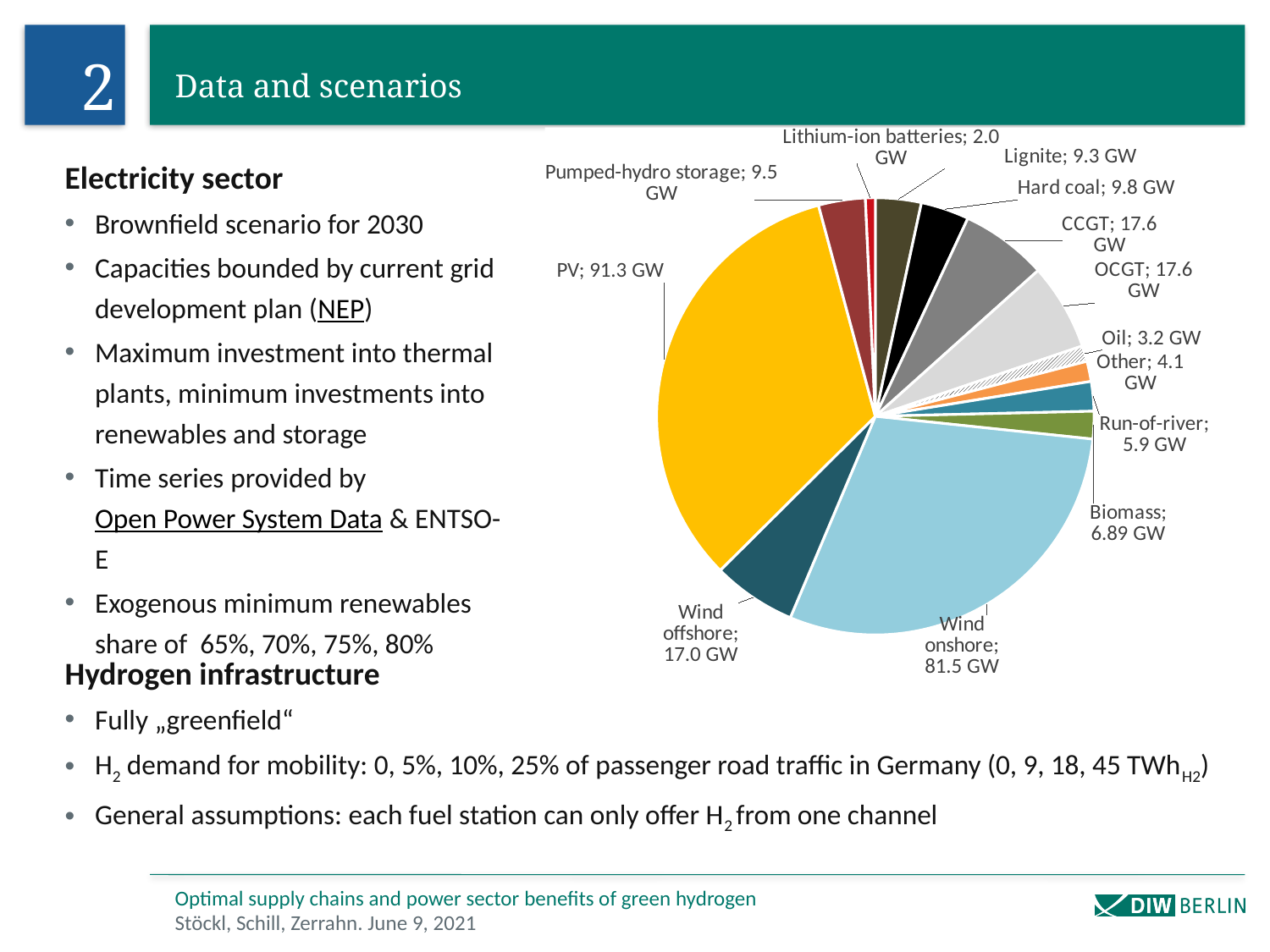
What is the difference between the PV capacity and the Wind onshore capacity? 9.8 GW What is the capacity shown for Biomass? 6.89 GW What is the capacity shown for PV in the pie chart? 91.3 GW What is the capacity shown for Wind onshore? 81.5 GW What is the capacity shown for Pumped-hydro storage? 9.5 GW What colour is the PV slice in the pie chart? yellow How many categories (slices) does the pie chart show? 13 Which is larger, the capacity for Wind offshore or for Pumped-hydro storage? Wind offshore Which category has the largest slice in the pie chart? PV What is the difference between the Hard coal capacity and the Lignite capacity? 0.5 GW What type of chart is shown on the slide? pie chart Which category has the smallest slice in the pie chart? Lithium-ion batteries